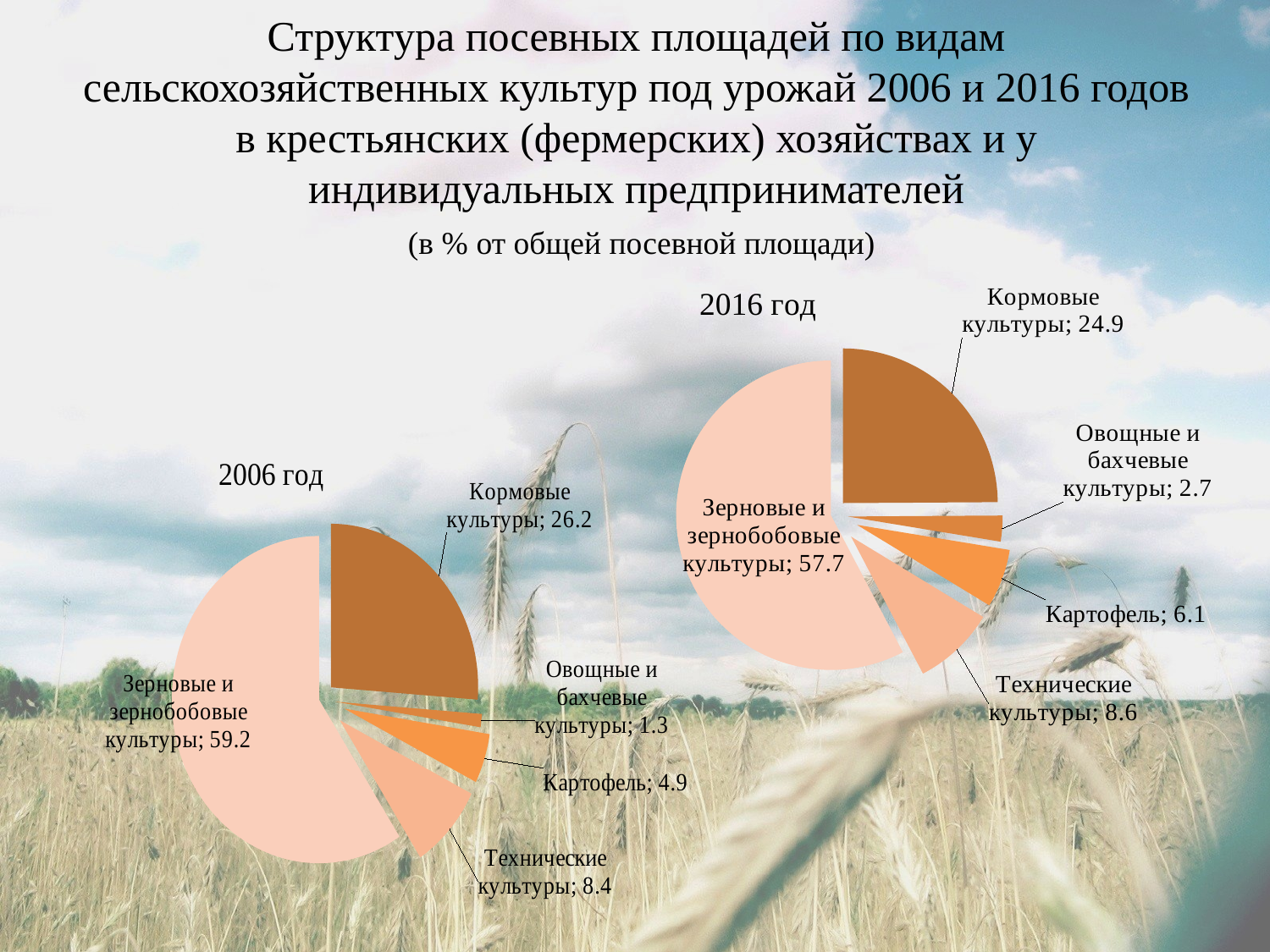
What type of chart is used for the 2006 год data? Pie chart In the 2006 год pie chart, which category has the smallest slice? Овощные и бахчевые культуры In the 2016 год pie chart, what is the value for Картофель? 6.1 In the 2006 год pie chart, what is the value for Технические культуры? 8.4 In the 2016 год pie chart, which category has the largest slice? Зерновые и зернобобовые культуры In the 2016 год pie chart, what is the value for Кормовые культуры? 24.9 What is the difference between the Кормовые культуры values in the 2006 год and 2016 год pie charts? 1.3 Which is larger: Картофель in the 2006 год chart or Картофель in the 2016 год chart? 2016 год How many categories are shown in the 2016 год pie chart? 5 In the 2006 год pie chart, what is the value for Зерновые и зернобобовые культуры? 59.2 How many pie charts are shown on the slide? 2 In the 2006 год pie chart, what is the difference between Зерновые и зернобобовые культуры and Кормовые культуры? 33